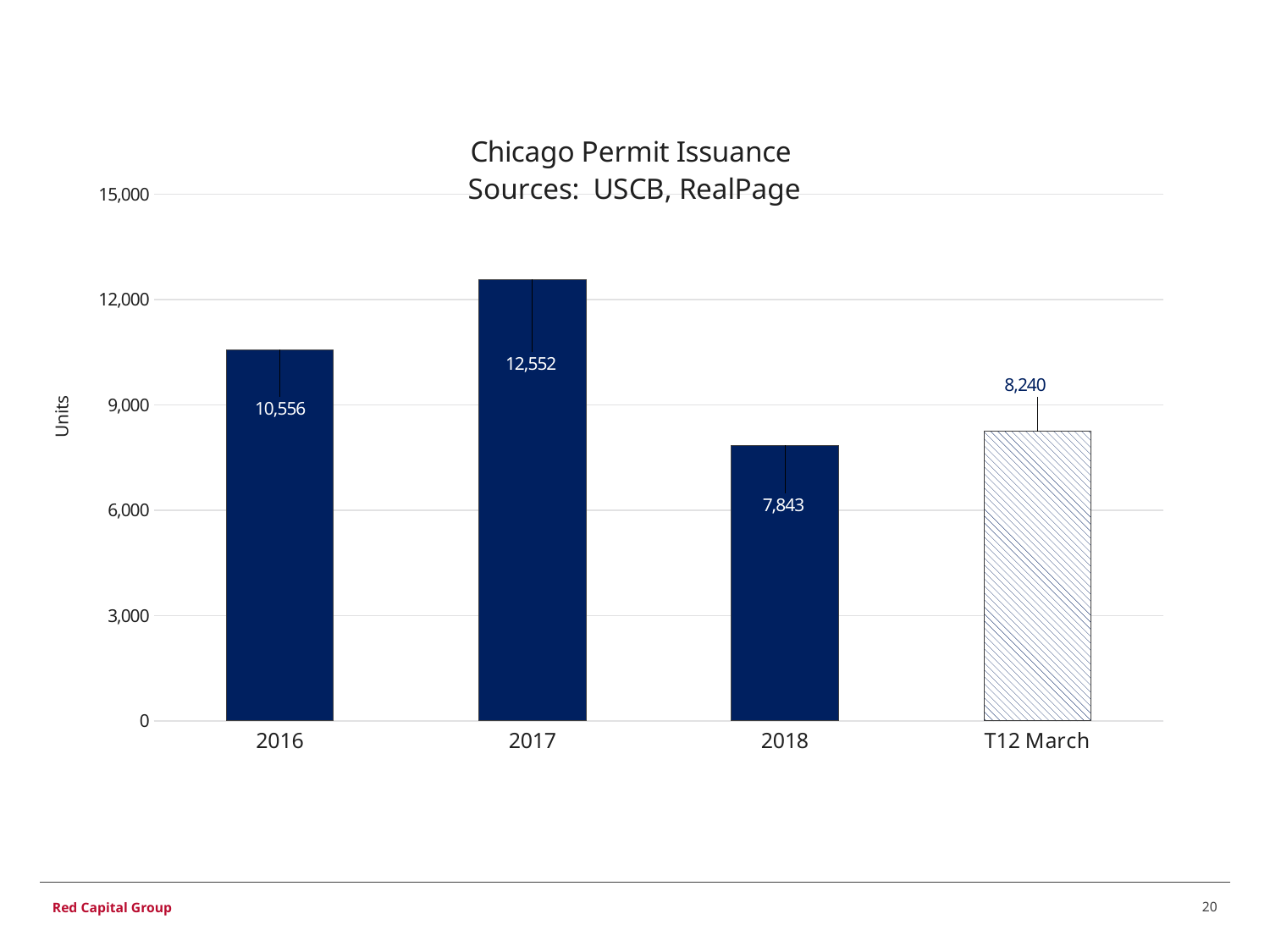
What is the value for 2017? 12,552 Which category has the lowest value? 2018 Which is larger, the value for 2016 or the value for T12 March? 2016 What is the value for 2018? 7,843 What is the value for 2016? 10,556 What kind of chart is this? bar chart What is the title of the chart? Chicago Permit Issuance Sources: USCB, RealPage What is the value for T12 March? 8,240 What is the difference between the values for 2016 and T12 March? 2,316 What is the difference between the values for 2017 and 2018? 4,709 Which category has the highest value? 2017 How many categories are shown on the x axis? 4